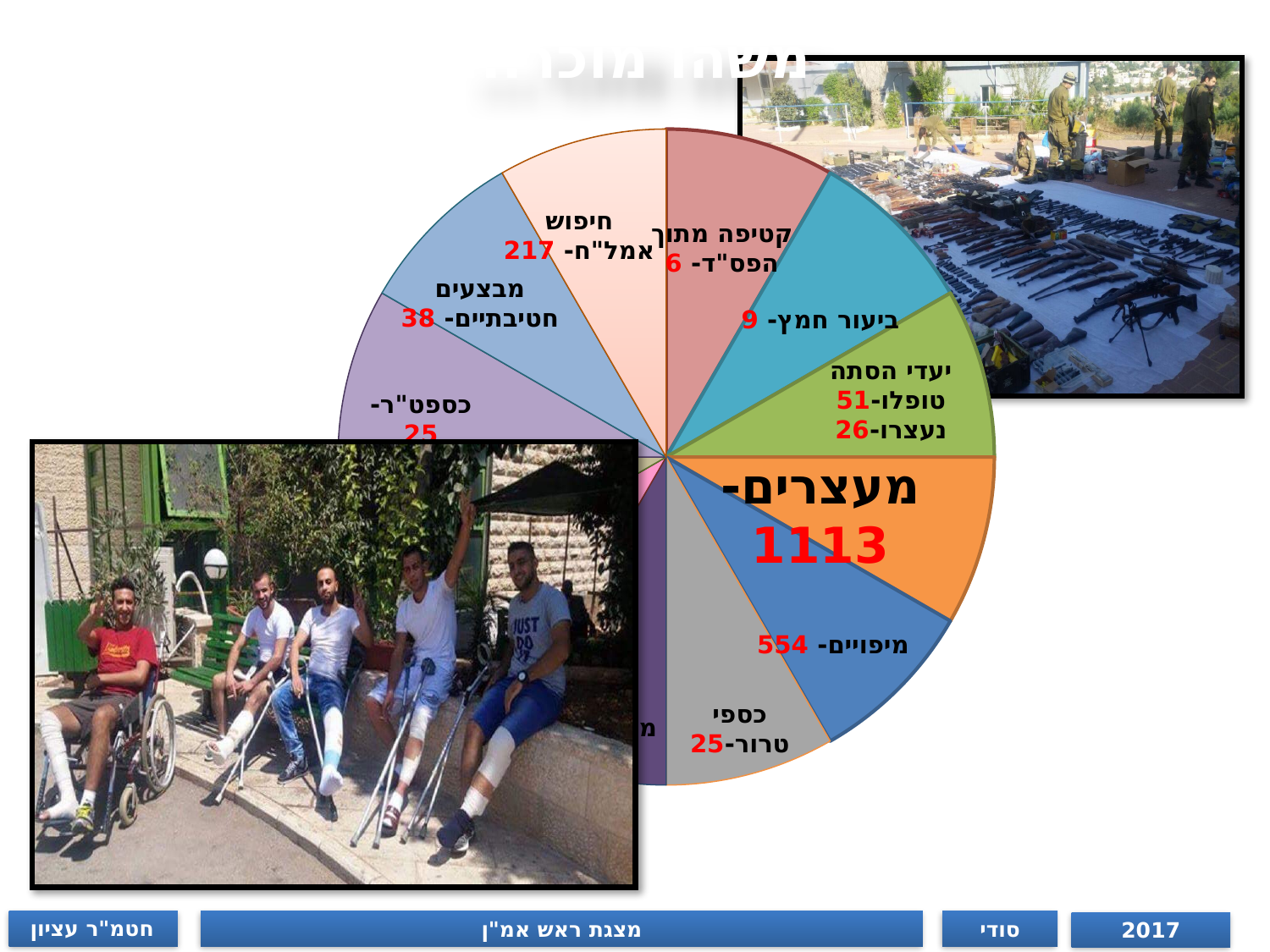
What is the difference between the values for מעצרים and מיפויים? 559 What colour is the מעצרים slice of the pie chart? orange What value is shown for מבצעים חטיבתיים in the pie chart? 38 What type of chart is shown on the slide? pie chart In the יעדי הסתה slice, how many are listed as טופלו and how many as נעצרו? טופלו 51, נעצרו 26 Which labelled category in the pie chart has the highest value? מעצרים Which has a larger value, חיפוש אמל"ח or מבצעים חטיבתיים? חיפוש אמל"ח What value is shown for מיפויים in the pie chart? 554 What value is shown for מעצרים in the pie chart? 1113 What value is shown for חיפוש אמל"ח in the pie chart? 217 What value is shown for ביעור חמץ in the pie chart? 9 What value is shown for כספי טרור in the pie chart? 25